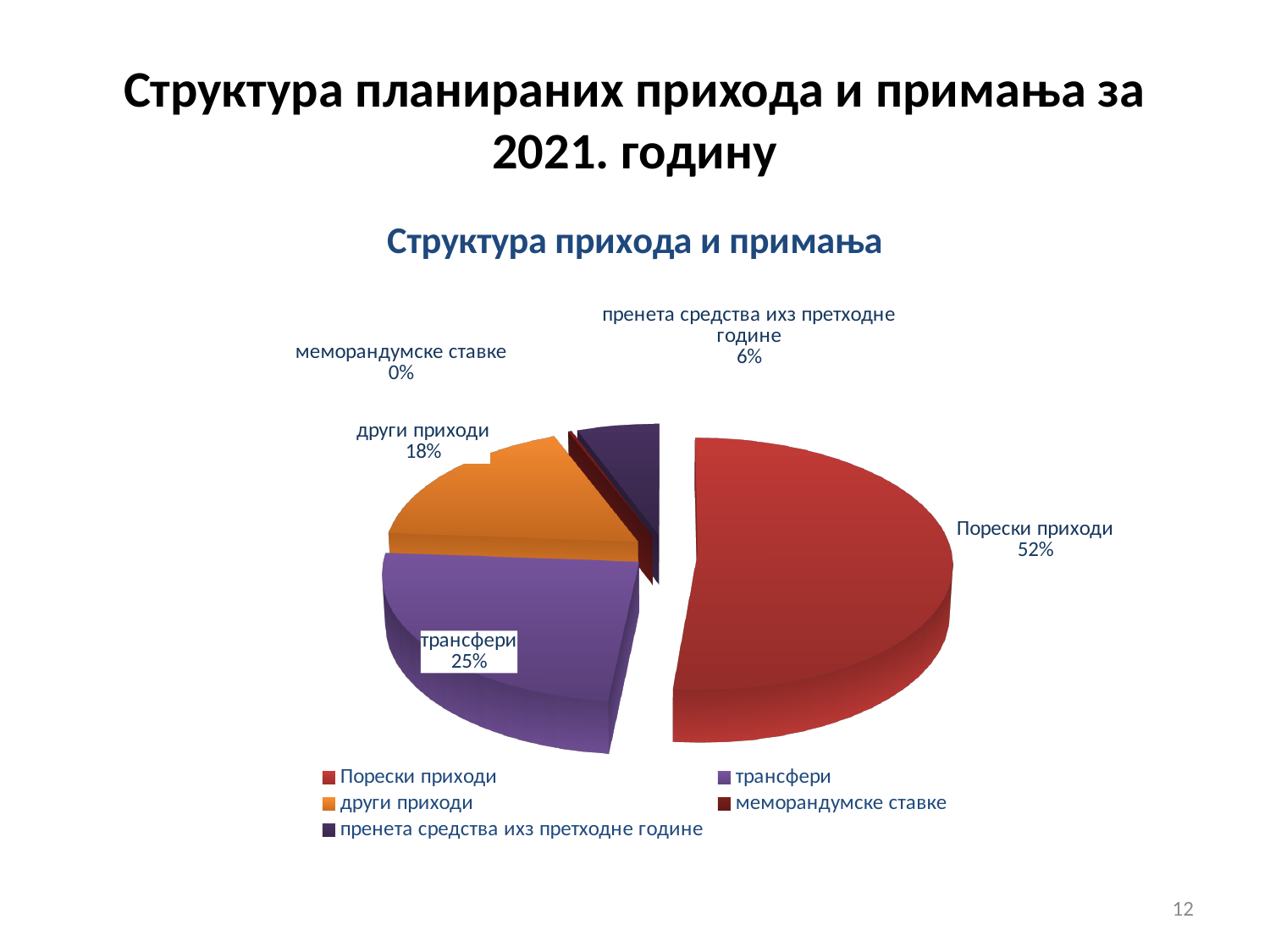
How many categories does the legend list? 5 What share of the pie does други приходи have? 18% Which category has the largest share of the pie? Порески приходи What share of the pie does трансфери have? 25% What type of chart is shown on the slide? Pie chart What is the difference in percentage points between Порески приходи and трансфери? 27 What share of the pie does меморандумске ставке have? 0% What is the chart's title? Структура прихода и примања Which category has the smallest share of the pie? меморандумске ставке Which is larger, други приходи or пренета средства ихз претходне године? други приходи